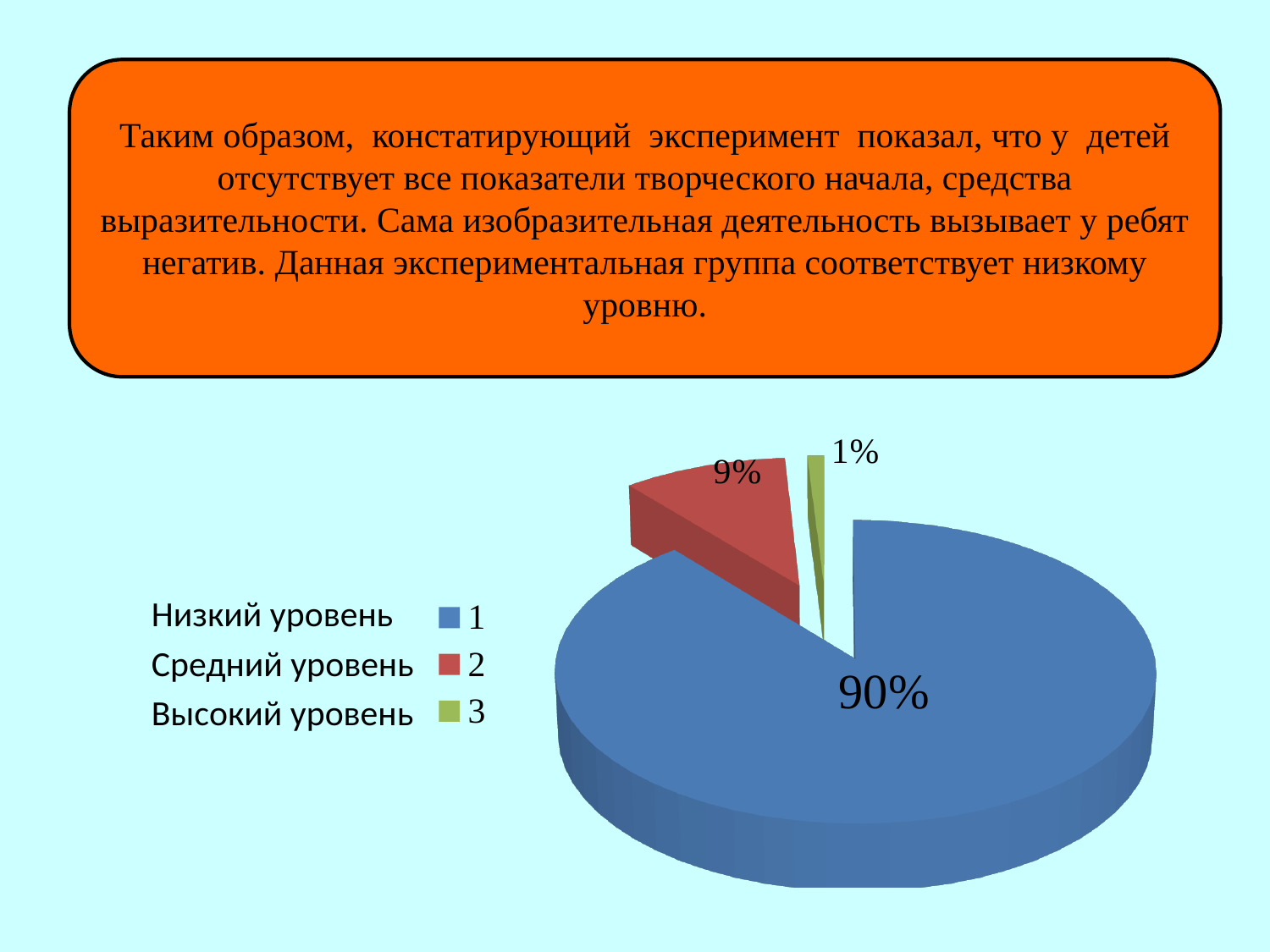
Which slice of the pie chart is the smallest? 3 (Высокий уровень) Which slice of the pie chart is the largest? 1 (Низкий уровень) What share of the pie does the slice labelled 2 take? 9% How many entries does the legend list? 3 What is the difference between the share for Низкий уровень and the share for Средний уровень? 81% What percentage is shown for the red slice (2, Средний уровень)? 9% What percentage is shown for the green slice (3, Высокий уровень)? 1% What percentage is shown for the blue slice (1, Низкий уровень)? 90% How many slices does the pie chart have? 3 Which is larger: the share for Средний уровень or the share for Высокий уровень? Средний уровень What colour is the slice for Высокий уровень (3)? green What kind of chart is shown on the slide? pie chart